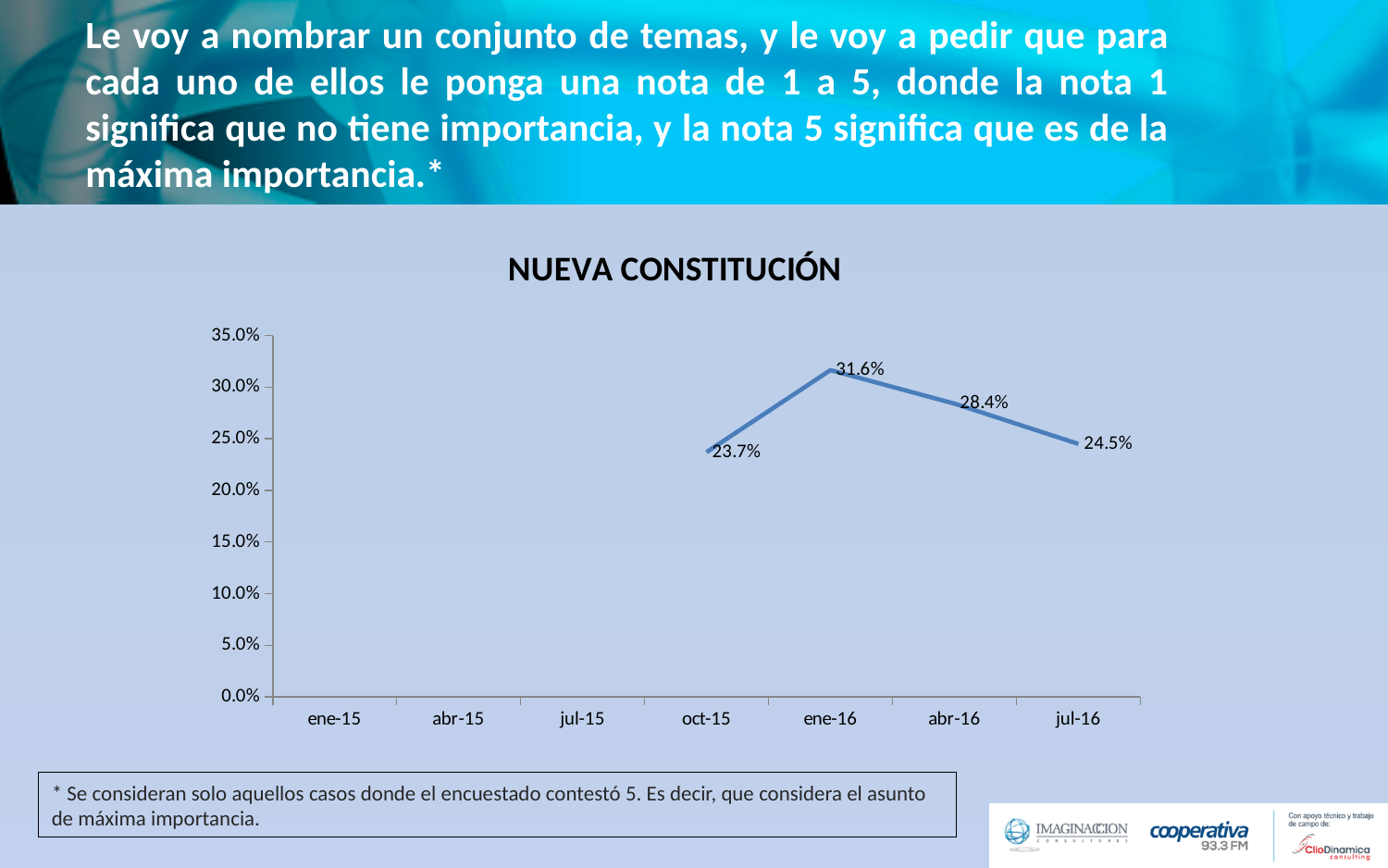
What kind of chart is shown on the slide? line chart What is the difference between the values for ene-16 and jul-16? 7.1% What is the value for oct-15? 23.7% Does the value rise or fall from ene-16 to jul-16? fall How many data points are plotted on the line? 4 Which is larger, the value for abr-16 or the value for jul-16? abr-16 What is the value for jul-16? 24.5% Which period has the lowest plotted value? oct-15 What is the value for abr-16? 28.4% What is the title of the chart? NUEVA CONSTITUCIÓN What is the value for ene-16? 31.6% Which period has the highest value? ene-16